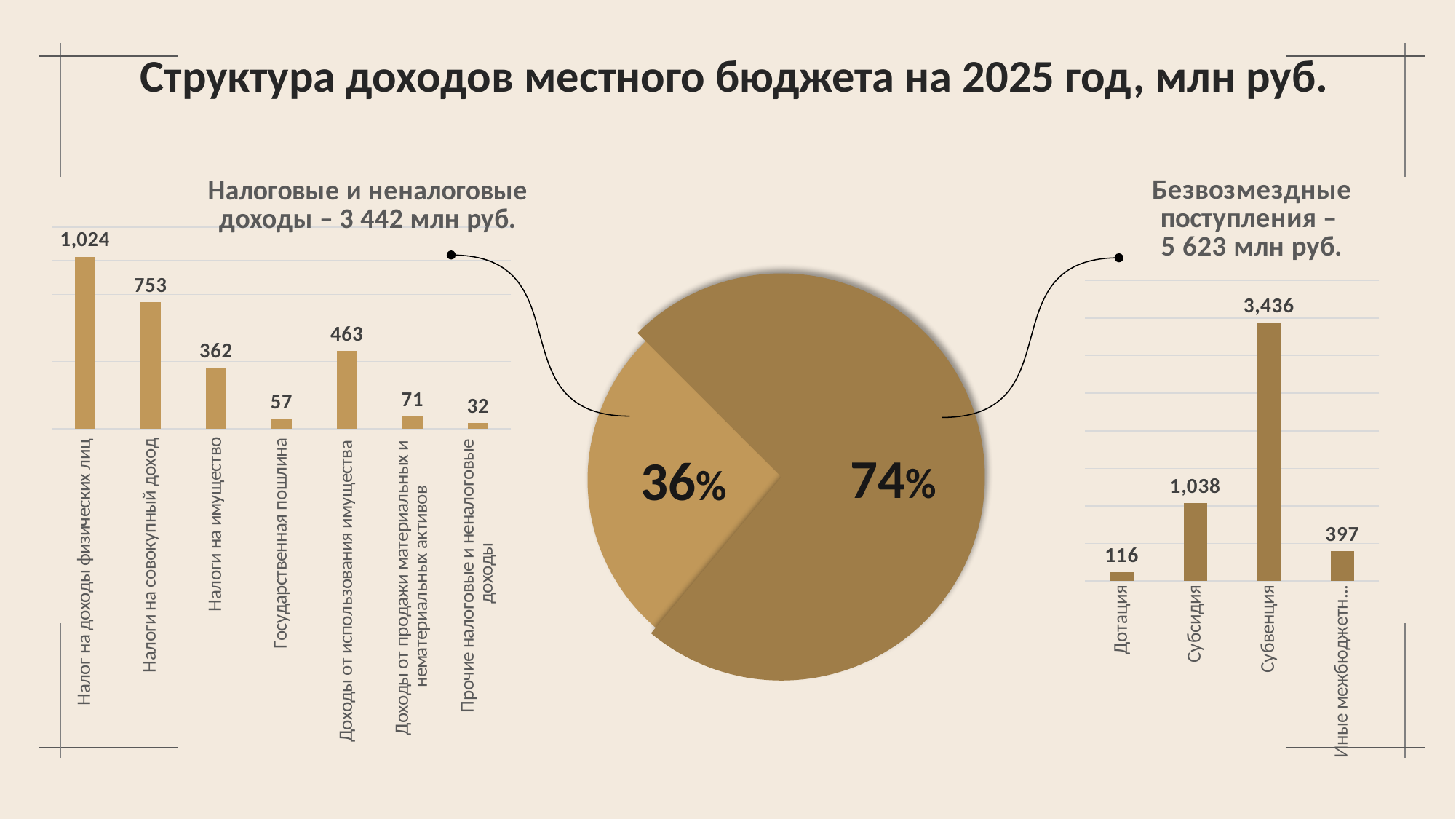
On the right bar chart, what is the value for Субвенция? 3,436 On the left bar chart, what is the value for Государственная пошлина? 57 On the left bar chart, what is the difference between Налоги на совокупный доход and Налоги на имущество? 391 On the left bar chart, which is larger: Доходы от использования имущества or Налоги на имущество? Доходы от использования имущества What kind of chart is in the centre of the slide? Pie chart On the centre pie chart, what percentage is shown on the smaller slice? 36% On the left bar chart, how many categories are shown? 7 On the left bar chart, which category has the lowest value? Прочие налоговые и неналоговые доходы On the right bar chart, what is the difference between Субсидия and Дотация? 922 On the right bar chart, how many categories are shown? 4 On the right bar chart, which category has the highest value? Субвенция On the left bar chart, what is the value for Налог на доходы физических лиц? 1,024